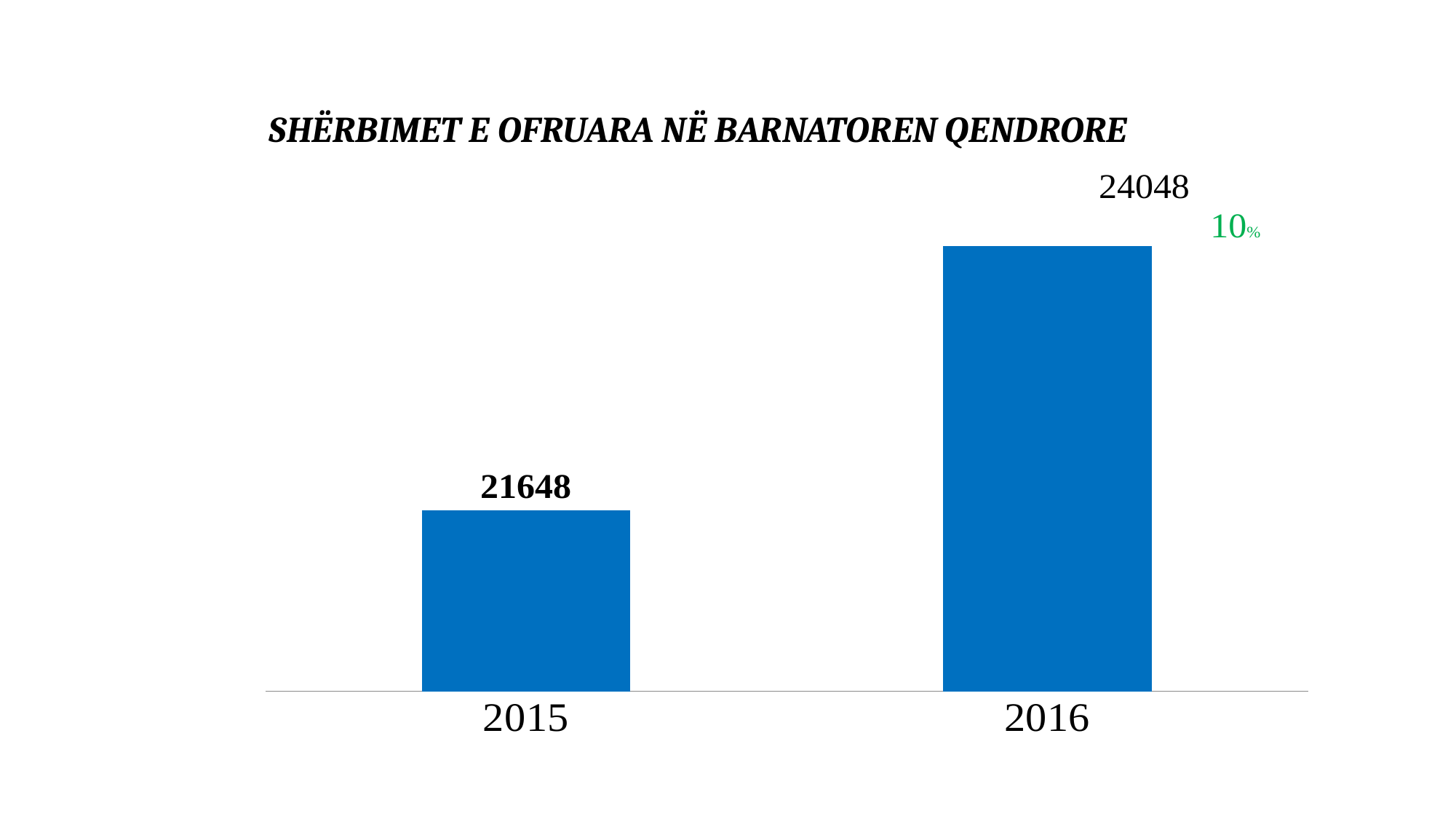
What percentage is shown in green next to the 2016 bar? 10% What is the value for 2016? 24048 What is the difference between the values for 2016 and 2015? 2400 How many years are shown on the chart? 2 Which year has the highest value? 2016 Do the values rise or fall from 2015 to 2016? rise What is the title of the chart? SHËRBIMET E OFRUARA NË BARNATOREN QENDRORE Which is larger, the value for 2015 or the value for 2016? 2016 What is the value for 2015? 21648 What kind of chart is shown on the slide? bar chart Which year has the lowest value? 2015